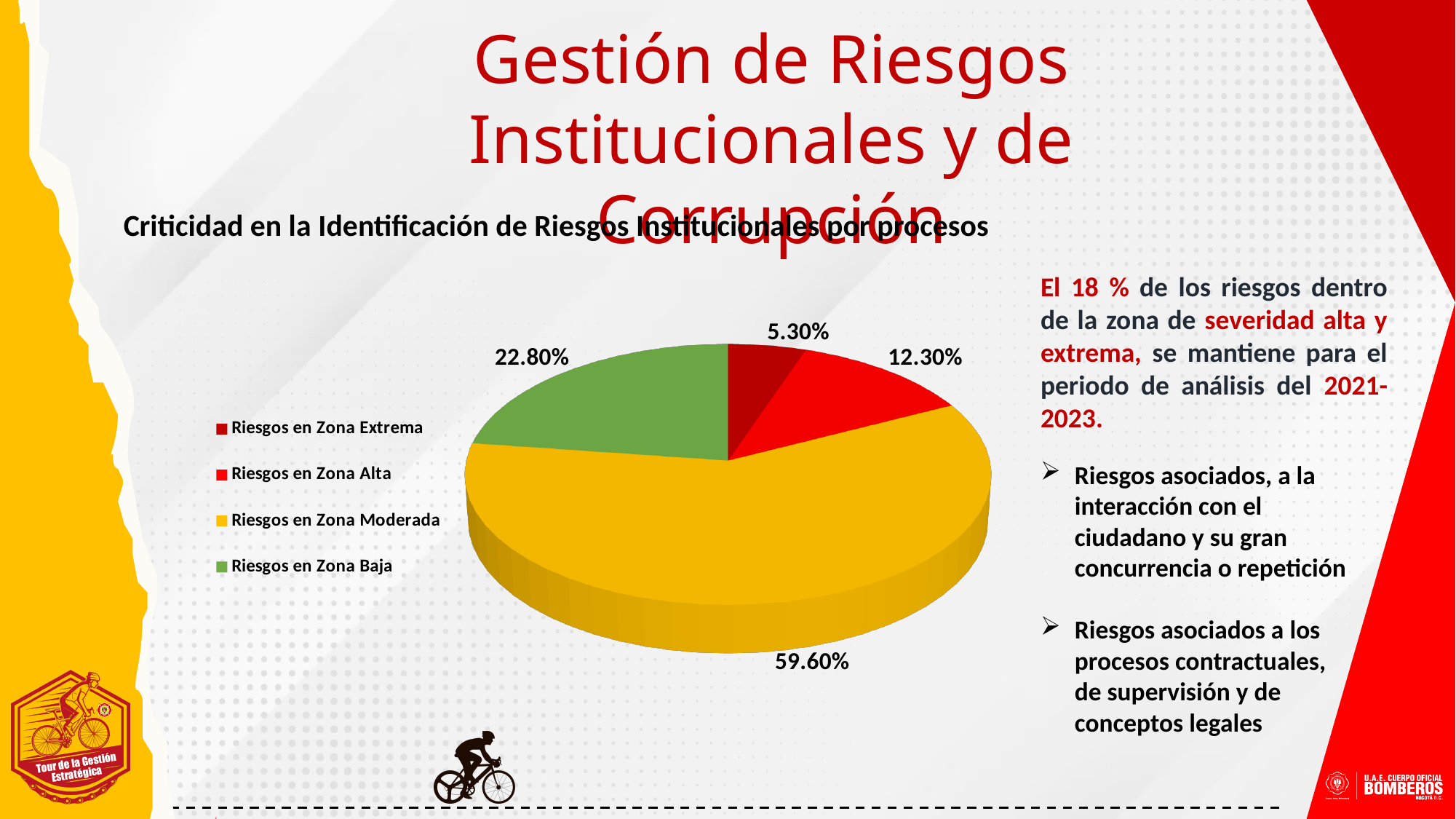
What colour represents Riesgos en Zona Baja in the pie chart? Green What percentage of the pie chart corresponds to Riesgos en Zona Moderada? 59.60% Which category has the largest share of the pie chart? Riesgos en Zona Moderada What percentage of the pie chart corresponds to Riesgos en Zona Extrema? 5.30% What type of chart is shown on the slide? Pie chart How many categories are shown in the pie chart? 4 Which is larger: the share for Riesgos en Zona Alta or the share for Riesgos en Zona Baja? Riesgos en Zona Baja Which category has the smallest share of the pie chart? Riesgos en Zona Extrema What percentage of the pie chart corresponds to Riesgos en Zona Baja? 22.80% What percentage of the pie chart corresponds to Riesgos en Zona Alta? 12.30% What is the difference in percentage points between Riesgos en Zona Baja and Riesgos en Zona Alta? 10.50 What is the combined share of Riesgos en Zona Extrema and Riesgos en Zona Alta? 17.60%